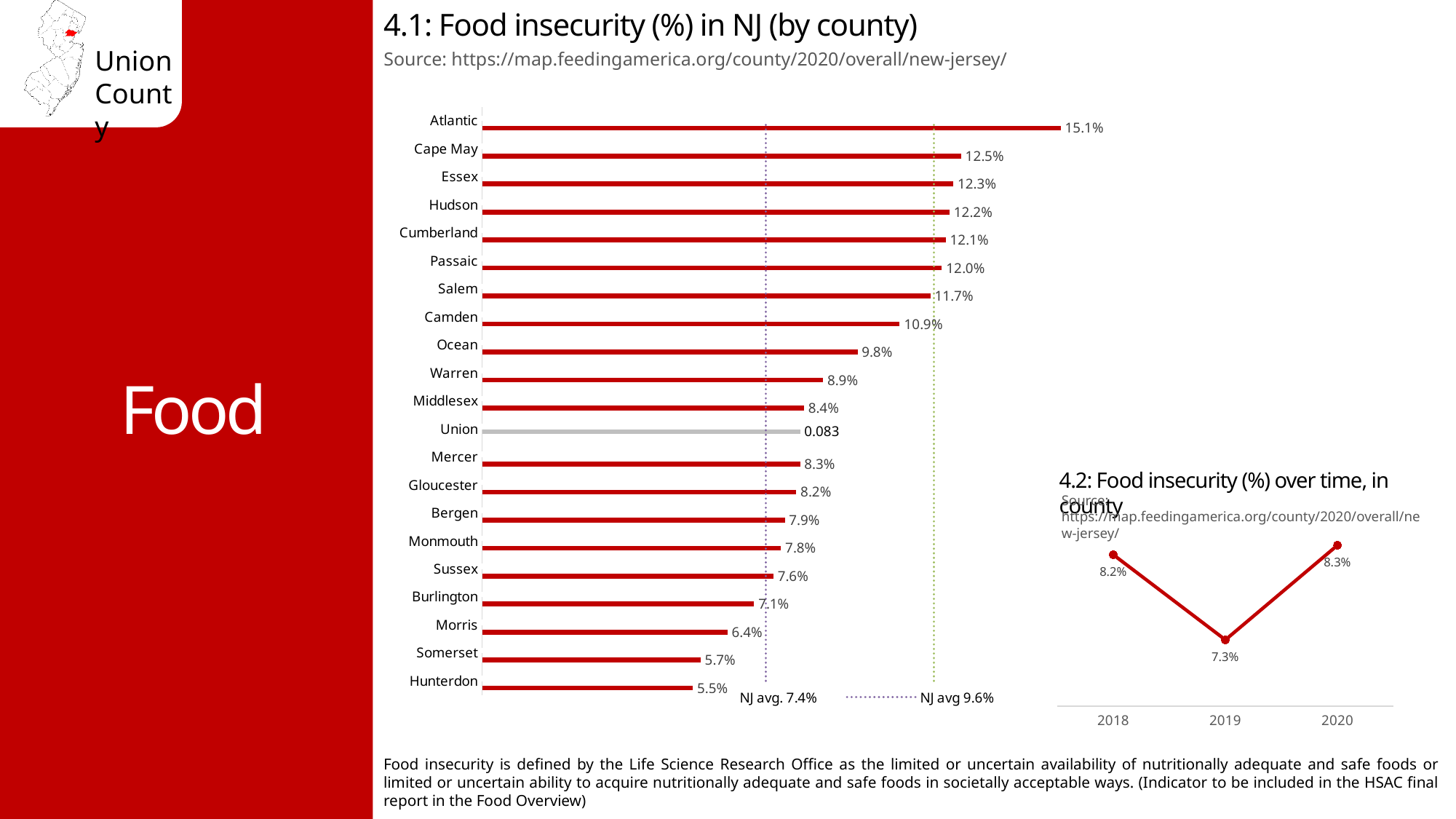
In chart 4.1 (Food insecurity (%) in NJ by county), what is the value for Atlantic? 15.1% In chart 4.1 (Food insecurity (%) in NJ by county), which county has the lowest food insecurity? Hunterdon In chart 4.2 (Food insecurity (%) over time, in county), which year has the highest value? 2020 In chart 4.2 (Food insecurity (%) over time, in county), what is the difference between the 2020 and 2019 values? 1.0% What kind of chart is chart 4.1 (Food insecurity (%) in NJ by county)? Bar chart In chart 4.1 (Food insecurity (%) in NJ by county), what is the label shown for the Union bar? 0.083 In chart 4.1 (Food insecurity (%) in NJ by county), what is the value for Camden? 10.9% In chart 4.1 (Food insecurity (%) in NJ by county), how many counties are plotted? 21 In chart 4.1 (Food insecurity (%) in NJ by county), which county has the highest food insecurity? Atlantic In chart 4.1 (Food insecurity (%) in NJ by county), what is the difference between Atlantic and Hunterdon? 9.6% In chart 4.2 (Food insecurity (%) over time, in county), what is the value for 2019? 7.3% In chart 4.1 (Food insecurity (%) in NJ by county), which is larger, the value for Ocean or the value for Warren? Ocean